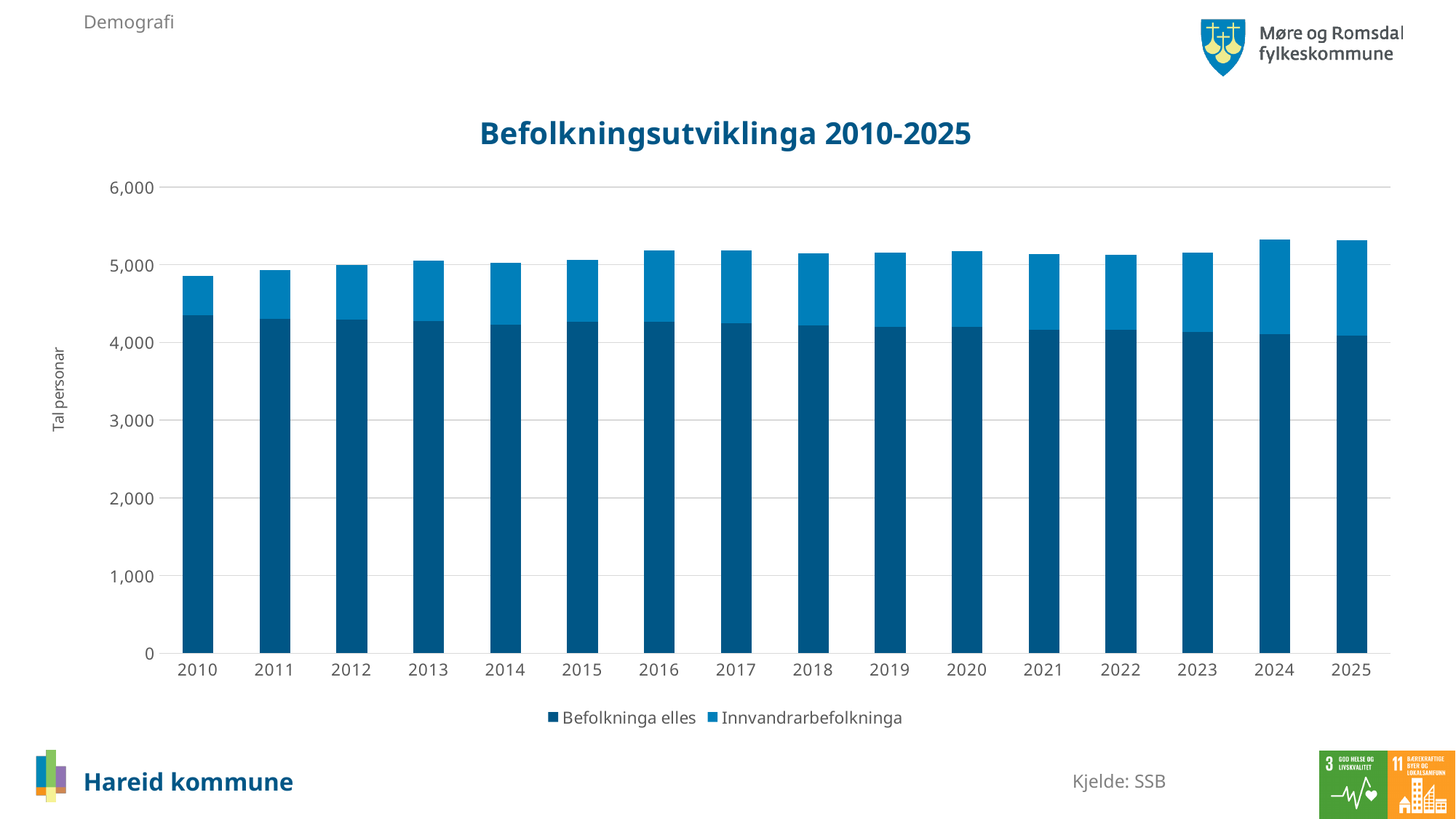
What is the title of the chart? Befolkningsutviklinga 2010-2025 What kind of chart is shown on the slide? Stacked bar chart Is the total population bar for 2010 greater or less than 5,000? less How many years are shown on the x axis of the chart? 16 Which is larger, the total population bar for 2010 or for 2024? 2024 Which year has the lowest total population bar? 2010 What are the two series named in the legend? Befolkninga elles and Innvandrarbefolkninga Is the value for Befolkninga elles in 2010 greater or less than 4,000? greater Is the total population bar for 2016 greater or less than 6,000? less How many series does the legend list? 2 Does the Befolkninga elles series rise or fall from 2010 to 2025? fall